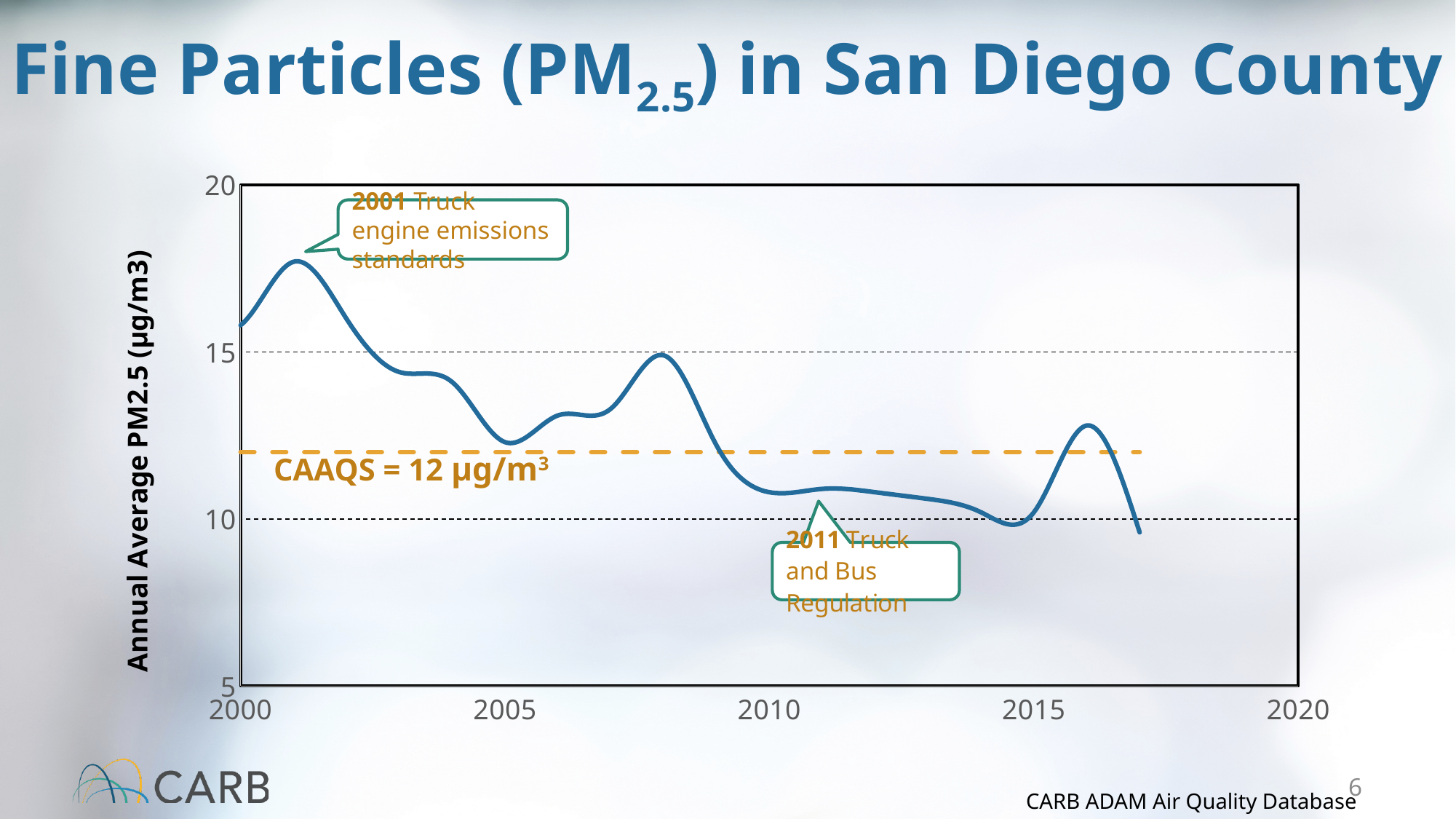
What value does the dashed CAAQS line on the chart represent? 12 µg/m³ Is the annual average PM2.5 value for 2005 greater or less than 15? less Is the annual average PM2.5 value for 2001 greater or less than 15? greater Is the annual average PM2.5 value for 2010 greater or less than 12? less What is the label of the vertical axis of the chart? Annual Average PM2.5 (µg/m3) Which year has the higher annual average PM2.5, 2001 or 2008? 2001 In which year does the annual average PM2.5 reach its highest value? 2001 Overall, do annual average PM2.5 values rise or fall from 2000 to 2017? fall What kind of chart is shown on the slide? line chart Which year has the higher annual average PM2.5, 2003 or 2010? 2003